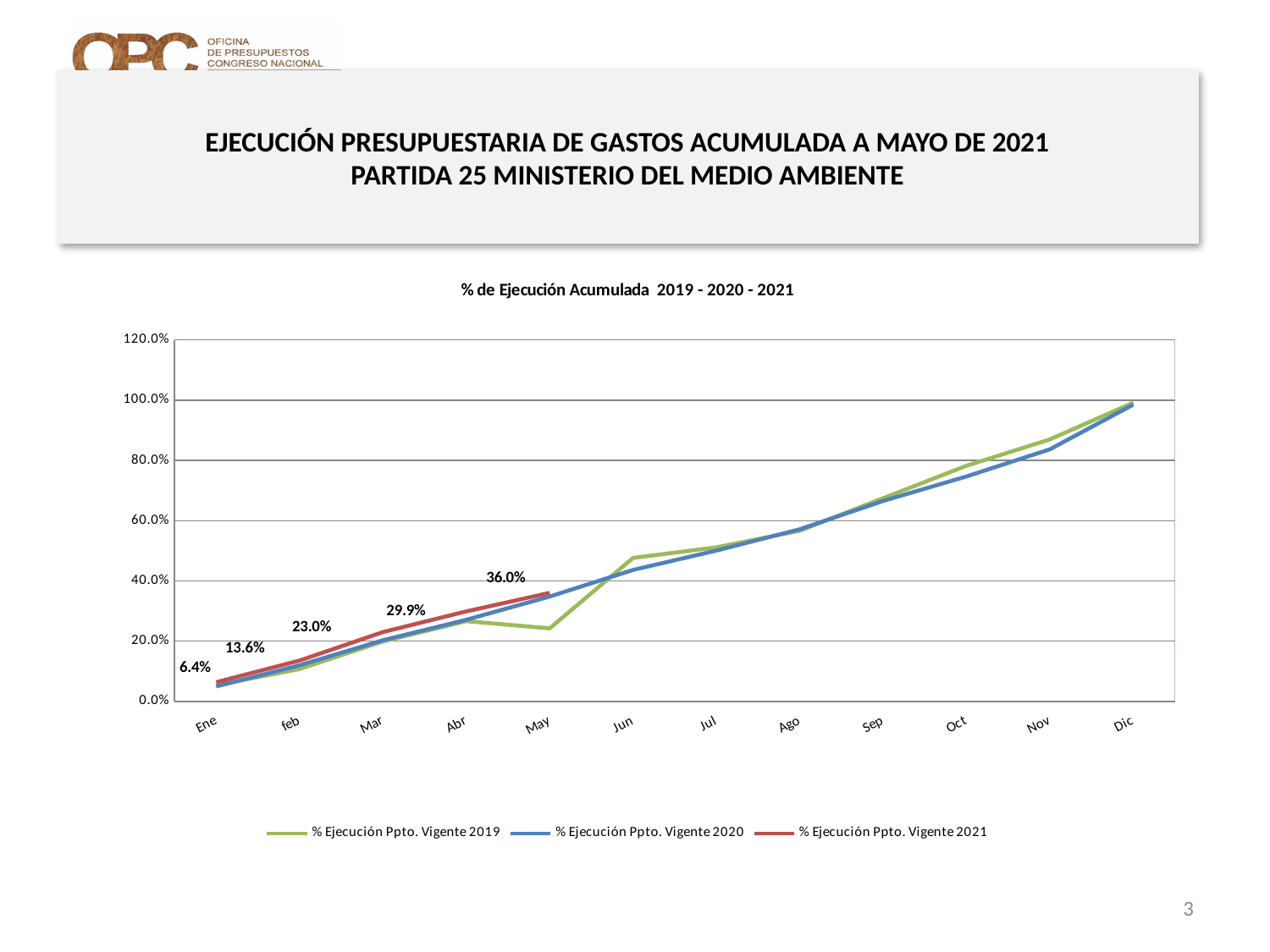
Does the % Ejecución Ppto. Vigente 2021 series rise or fall from Ene to May? Rises What is the difference between the 2021 values for May and Abr? 6.1% How many months are shown on the x axis? 12 How many series does the legend list? 3 What is the value of % Ejecución Ppto. Vigente 2021 in Abr? 29.9% What kind of chart is shown on the slide? Line chart What is the difference between the 2021 values for Mar and feb? 9.4% In which month does the % Ejecución Ppto. Vigente 2021 series reach its highest labelled value? May What is the value of % Ejecución Ppto. Vigente 2021 in Ene? 6.4% What is the value of % Ejecución Ppto. Vigente 2021 in Mar? 23.0% Is the value for % Ejecución Ppto. Vigente 2019 in Jun greater or less than 40.0%? greater What is the value of % Ejecución Ppto. Vigente 2021 in May? 36.0%